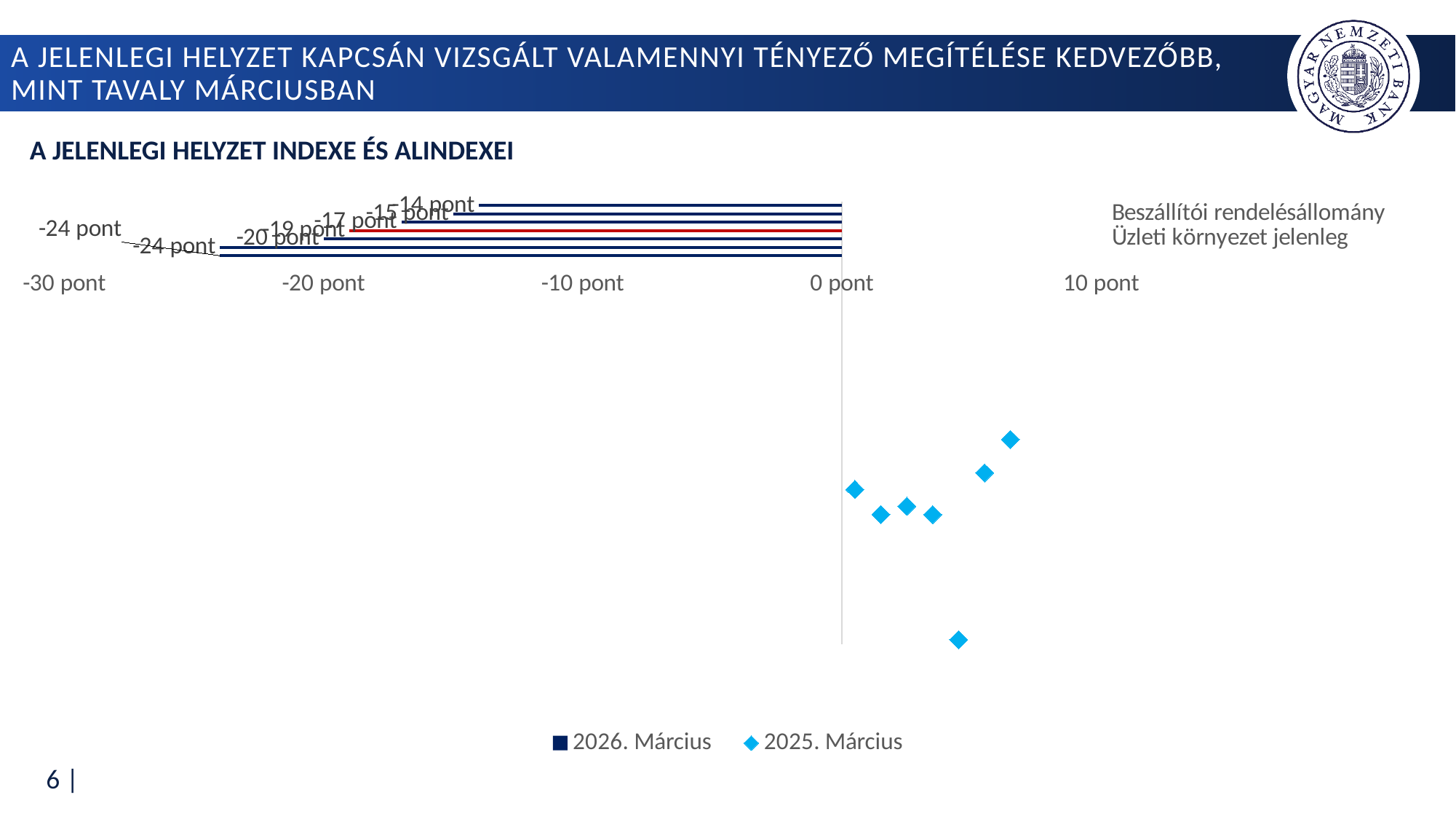
What is the title of the chart on the slide? A JELENLEGI HELYZET INDEXE ÉS ALINDEXEI What are the minimum and maximum tick labels on the horizontal axis? -30 pont and 10 pont What are the two series named in the chart legend? 2026. Március and 2025. Március Are the 2026. Március bar values greater or less than 0 pont? less What is the highest value labelled on the 2026. Március bars? -14 pont How many series does the chart legend list? 2 What kind of chart is used for the 2026. Március series? Bar chart How many bars are plotted for the 2026. Március series? 7 Are the 2025. Március diamond markers greater or less than 0 pont? greater What is the lowest value labelled on the 2026. Március bars? -24 pont What is the difference between the highest and lowest labelled 2026. Március bar values? 10 pont How many diamond markers are plotted for the 2025. Március series? 7